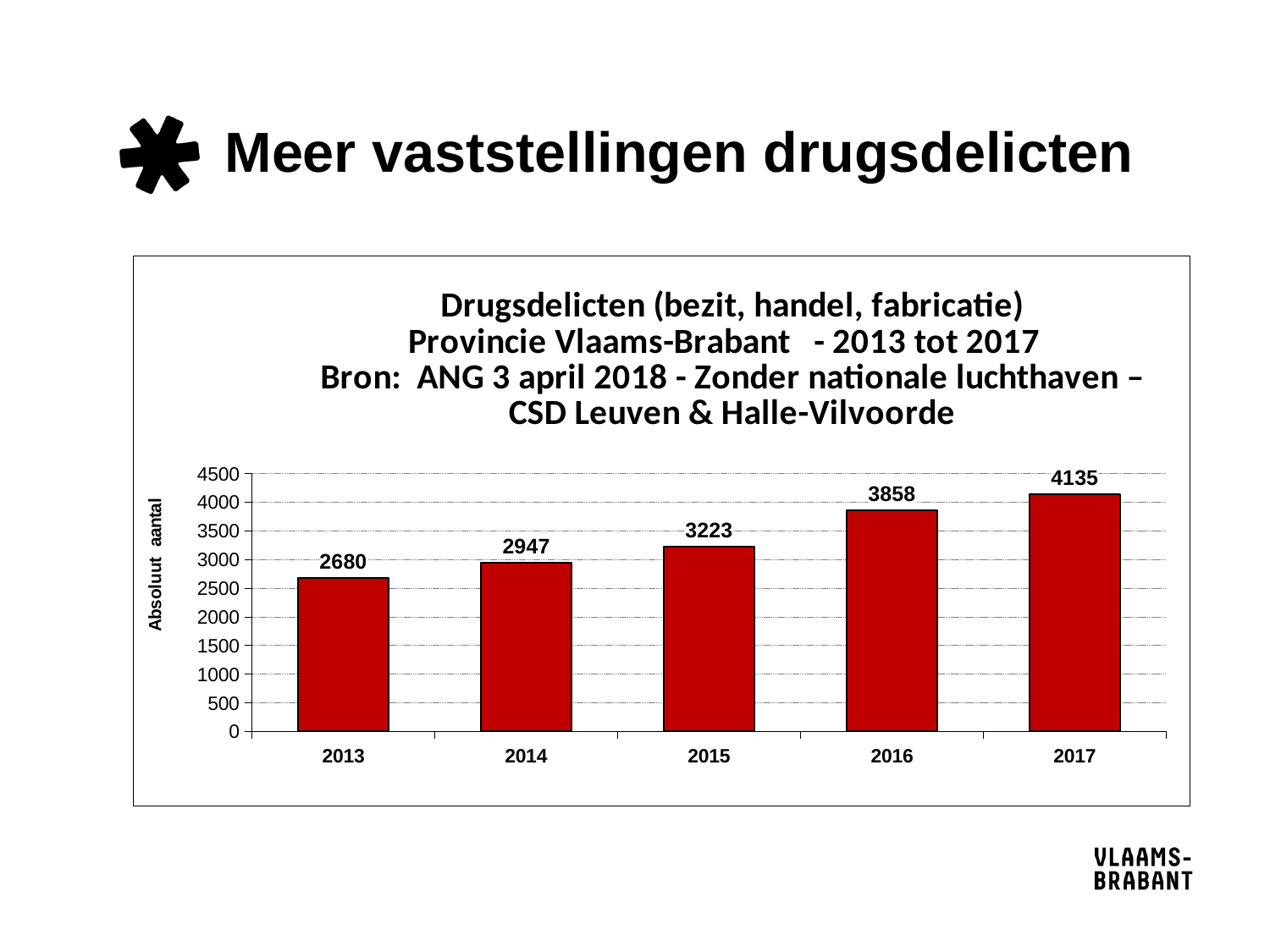
Which is larger, the value for 2014 or the value for 2016? 2016 What is the difference between the values for 2015 and 2014? 276 What is the label of the vertical axis? Absoluut aantal How many years are shown on the x axis? 5 Which year has the lowest value? 2013 What is the difference between the values for 2017 and 2013? 1455 What kind of chart is shown? bar chart Which year has the highest value? 2017 What is the value for 2016? 3858 Is the value for 2015 greater or less than 3000? greater What is the value for 2013? 2680 Do the values rise or fall from 2013 to 2017? rise